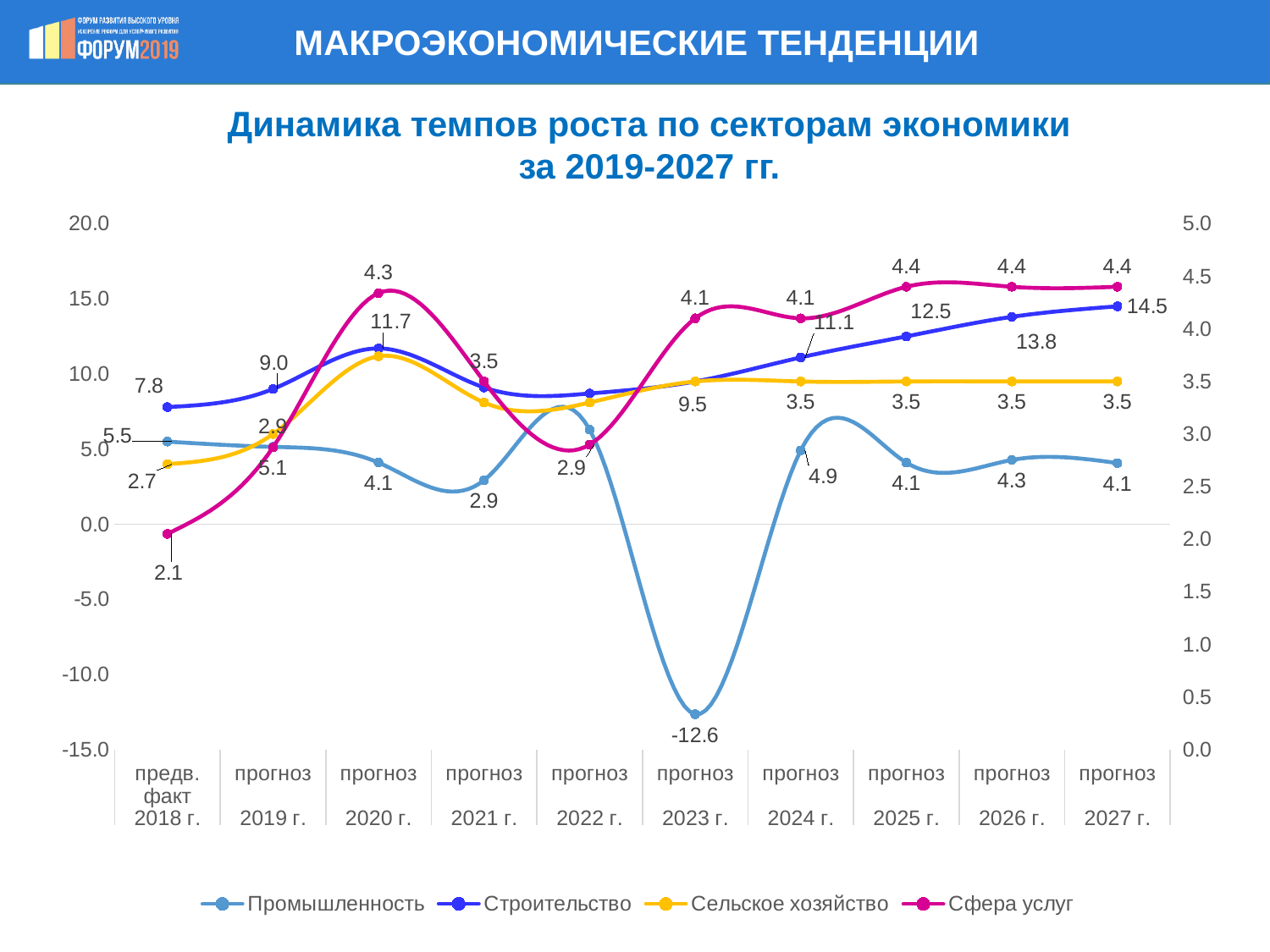
Does the Строительство line rise or fall from 2023 г. to 2027 г.? Rises How many series does the legend list? 4 By how much does the Строительство value in 2027 г. exceed its value in 2018 г.? 6.7 In which year does Строительство reach its highest value? 2027 г. What is the value for Промышленность in 2023 г.? -12.6 Which is larger for Промышленность: the value in 2024 г. or in 2025 г.? 2024 г. What is the value for Строительство in 2027 г.? 14.5 What kind of chart is shown on the slide? Line chart In which year does Промышленность reach its lowest value? 2023 г. What is the value for Сельское хозяйство in 2018 г. (предв. факт)? 2.7 What is the value for Сфера услуг in 2018 г. (предв. факт)? 2.1 How many years (categories) are shown along the x axis? 10